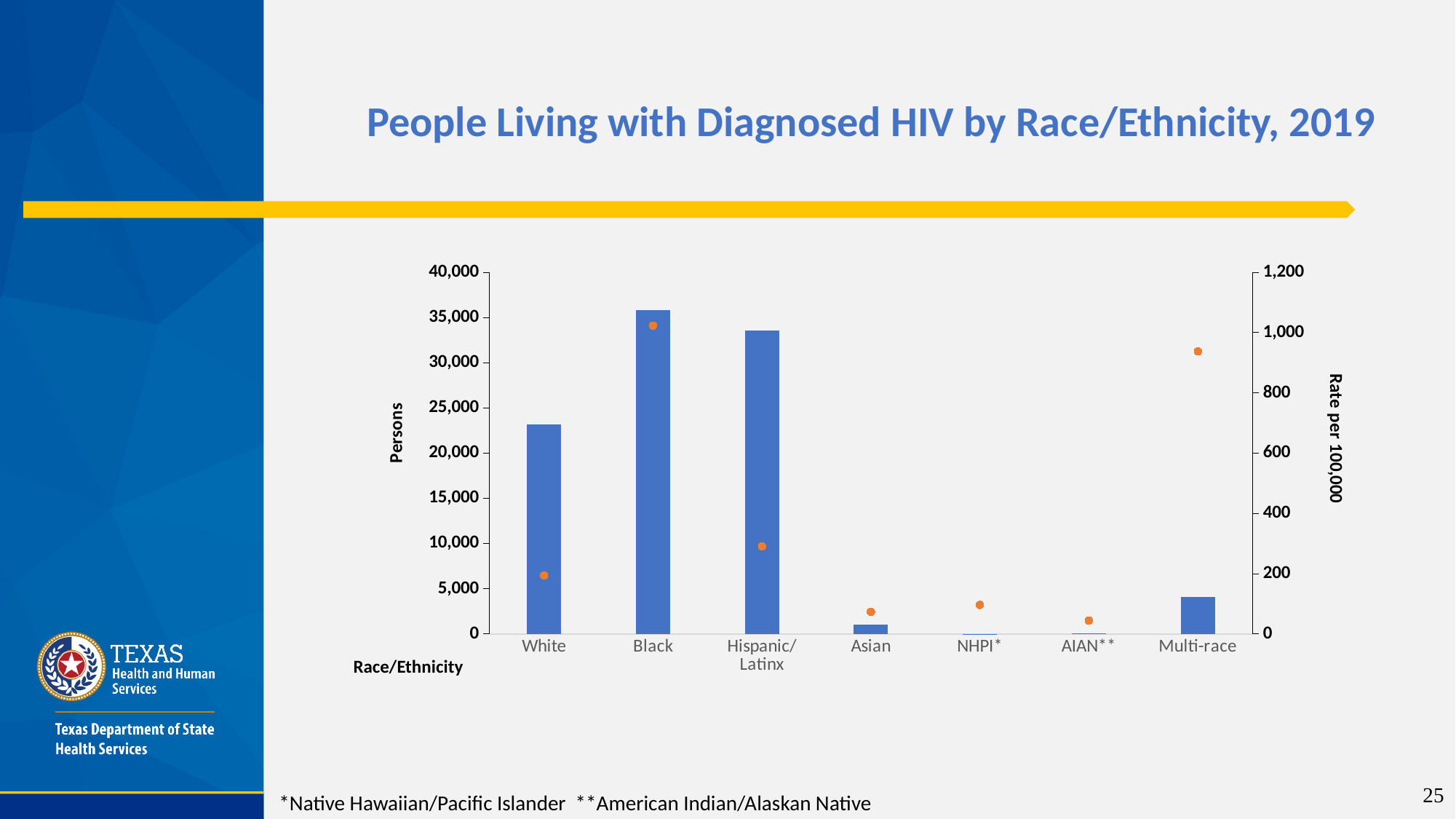
Is the number of persons for White greater or less than 20,000? greater Which has more persons living with diagnosed HIV, White or Hispanic/Latinx? Hispanic/Latinx What kind of chart is shown on the slide? combination bar and line chart (bars with orange markers) How many race/ethnicity categories are shown on the x axis? 7 Is the number of persons for Hispanic/Latinx greater or less than 35,000? less Which race/ethnicity has the highest rate per 100,000 (orange marker)? Black Is the number of persons for Multi-race greater or less than 5,000? less Which race/ethnicity has the tallest bar for persons living with diagnosed HIV? Black What is the title of the right-hand vertical axis? Rate per 100,000 Which has a higher rate per 100,000, White or Hispanic/Latinx? Hispanic/Latinx